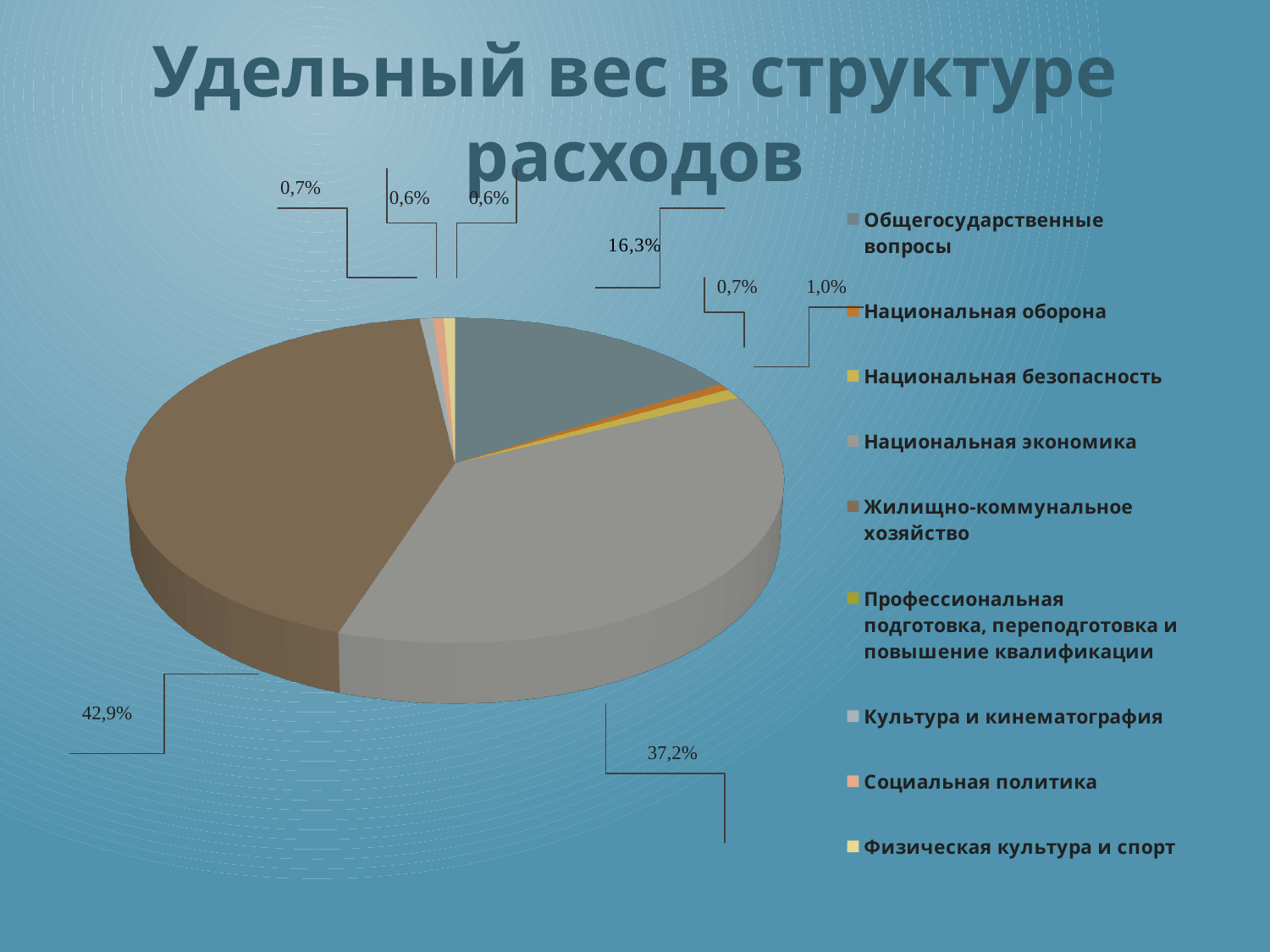
What share does Национальная безопасность have? 1,0% What share does Национальная оборона have? 0,7% What share does Жилищно-коммунальное хозяйство have? 42,9% What share does Национальная экономика have? 37,2% What is the difference in percentage points between Жилищно-коммунальное хозяйство and Национальная экономика? 5,7 What kind of chart is shown on the slide? pie chart What is the title of the chart? Удельный вес в структуре расходов Which is larger: the share of Национальная экономика or the share of Общегосударственные вопросы? Национальная экономика How many categories does the legend list? 9 What is the combined share of Жилищно-коммунальное хозяйство and Национальная экономика? 80,1% What share does Общегосударственные вопросы have? 16,3% Which category has the largest share of the pie? Жилищно-коммунальное хозяйство